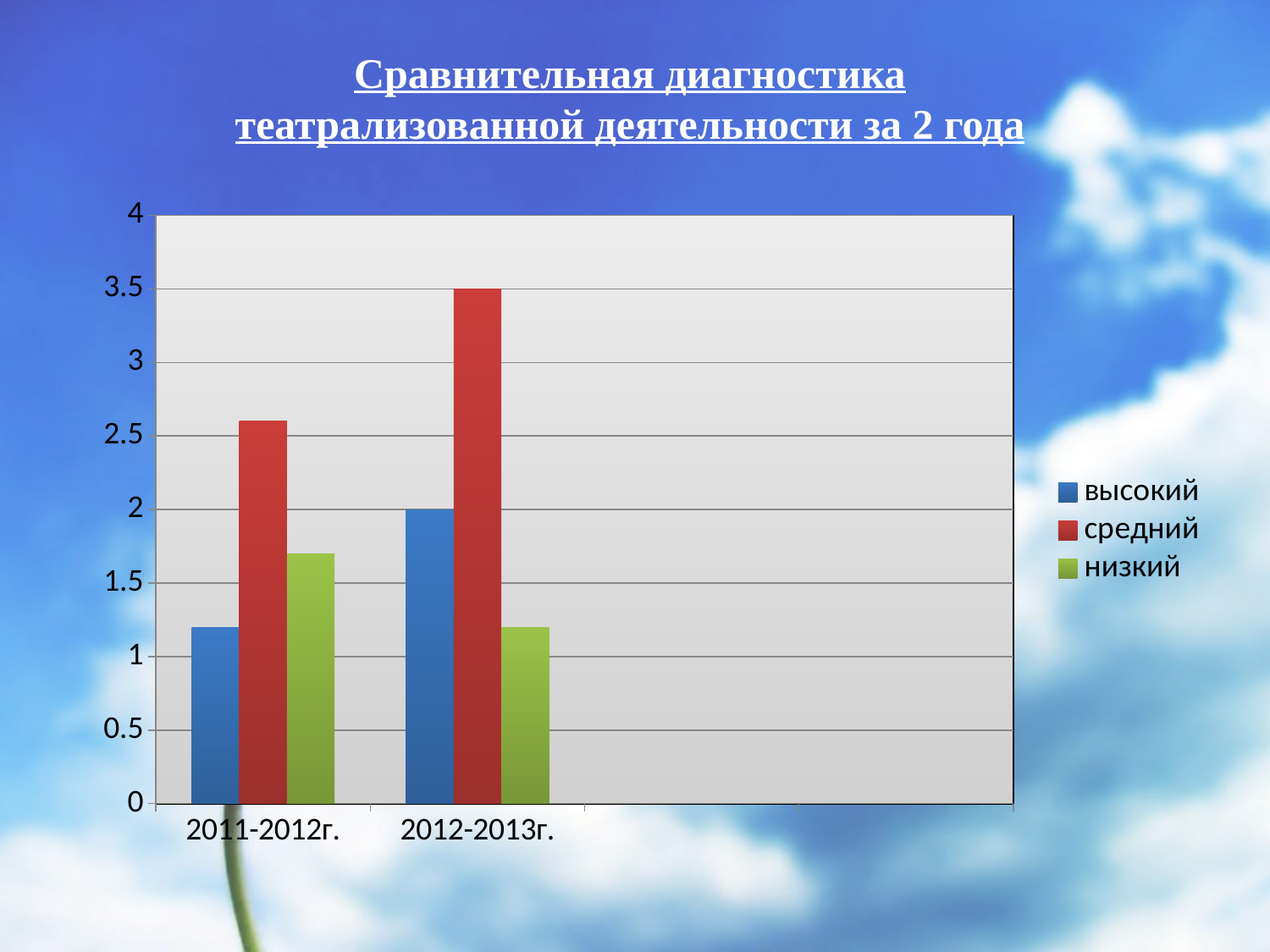
Which is larger: высокий in 2011-2012г. or высокий in 2012-2013г.? высокий in 2012-2013г. What is the value for средний in 2012-2013г.? 3.5 How many categories are shown on the x axis? 2 Is the value for низкий in 2011-2012г. greater or less than 1.5? greater What is the value for высокий in 2012-2013г.? 2 How many series does the legend list? 3 Is the value for высокий in 2011-2012г. greater or less than 1.5? less Which series has the highest value in 2012-2013г.? средний What kind of chart is shown on the slide? bar chart Does the value for низкий rise or fall from 2011-2012г. to 2012-2013г.? fall Is the value for низкий in 2012-2013г. greater or less than 1.5? less